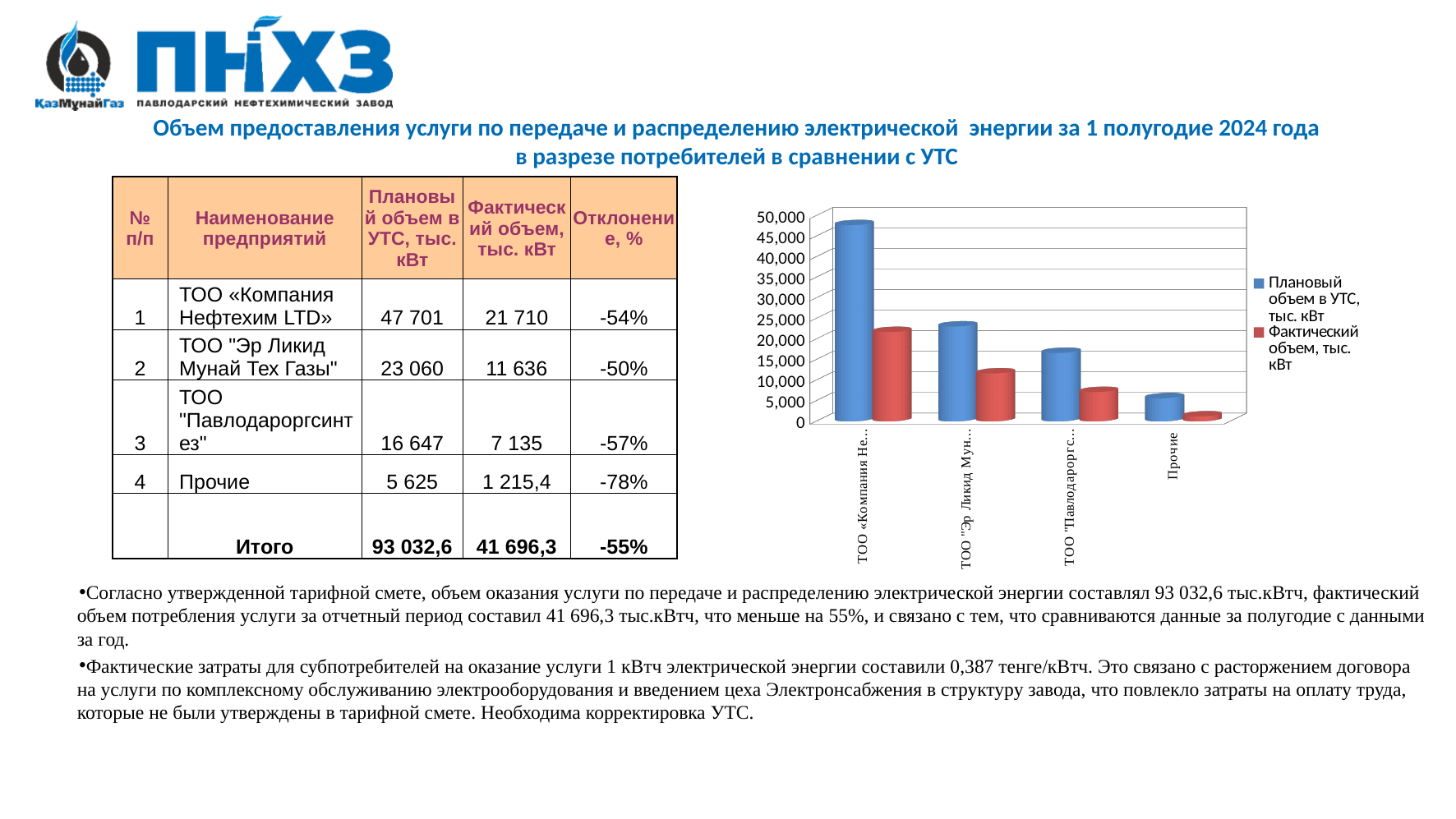
Is the actual volume (Фактический объем) for ТОО "Павлодароргсинтез" greater or less than 10,000? less Is the planned volume (Плановый объем в УТС) for ТОО «Компания Нефтехим LTD» greater or less than 45,000? greater Is the actual volume (Фактический объем) for Прочие greater or less than 5,000? less What kind of chart is shown on the slide? bar chart Which is larger for ТОО "Эр Ликид Мунай Тех Газы": the planned volume or the actual volume? planned volume Which category has the lowest actual volume (Фактический объем) bar? Прочие How many categories are shown on the x axis of the chart? 4 How many series does the chart legend list? 2 Which category has the highest planned volume (Плановый объем в УТС) bar? ТОО «Компания Нефтехим LTD» Do the planned volume (Плановый объем в УТС) bars rise or fall from left to right along the x axis? fall What colour are the bars for the series Фактический объем, тыс. кВт? red